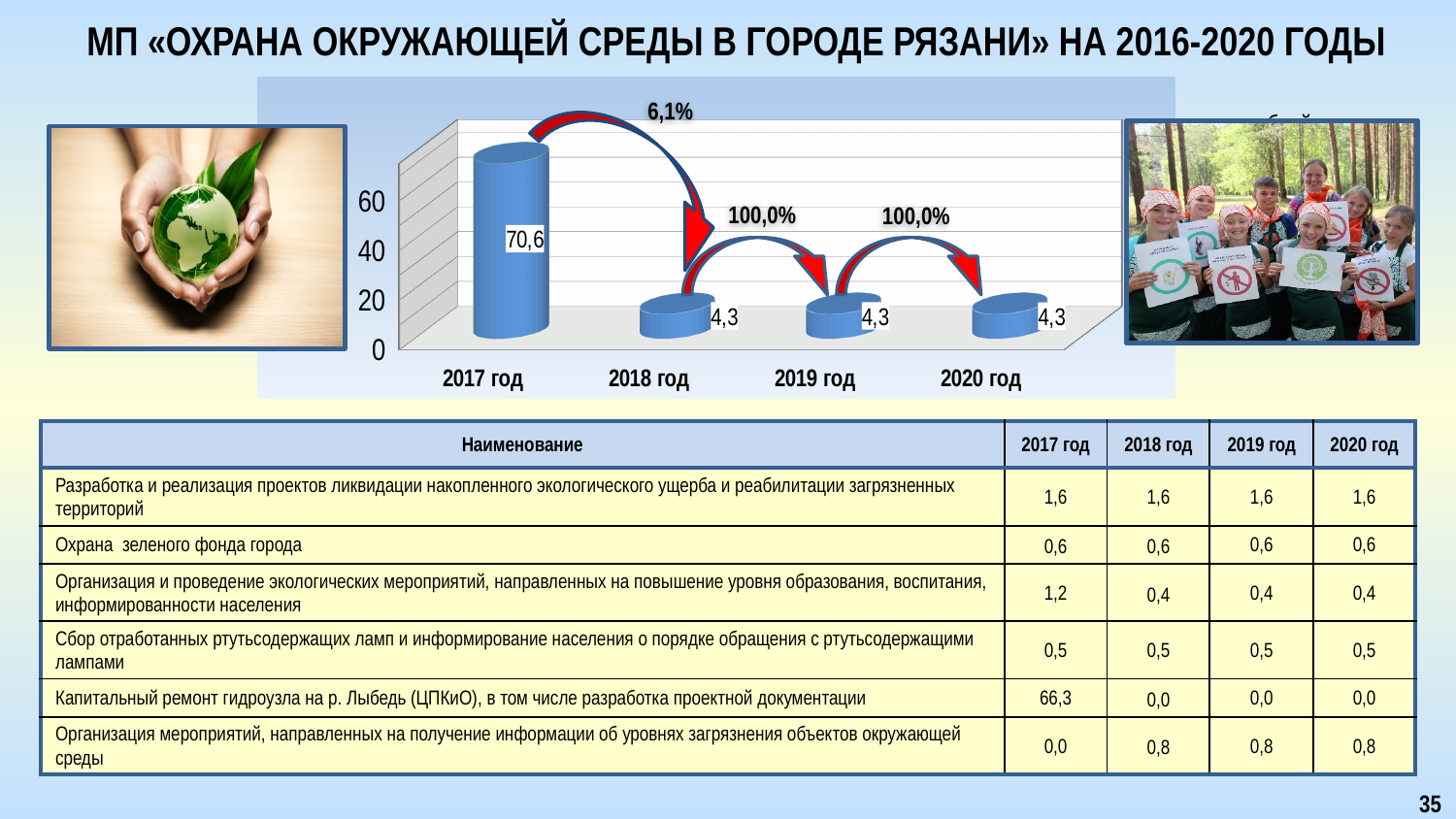
What is the difference between the values for 2017 год and 2018 год? 66,3 What is the value for 2017 год in the chart? 70,6 Is the value for 2017 год greater or less than 60? greater Which is larger, the value for 2017 год or the value for 2019 год? 2017 год Which year has the highest value in the chart? 2017 год What is the value for 2018 год in the chart? 4,3 What percentage is printed on the arrow between 2017 год and 2018 год? 6,1% What is the value for 2020 год in the chart? 4,3 Is the value for 2019 год greater or less than 20? less What kind of chart is shown on the slide? bar chart How many years are shown on the x axis of the chart? 4 Do the values rise or fall from 2017 год to 2018 год? fall